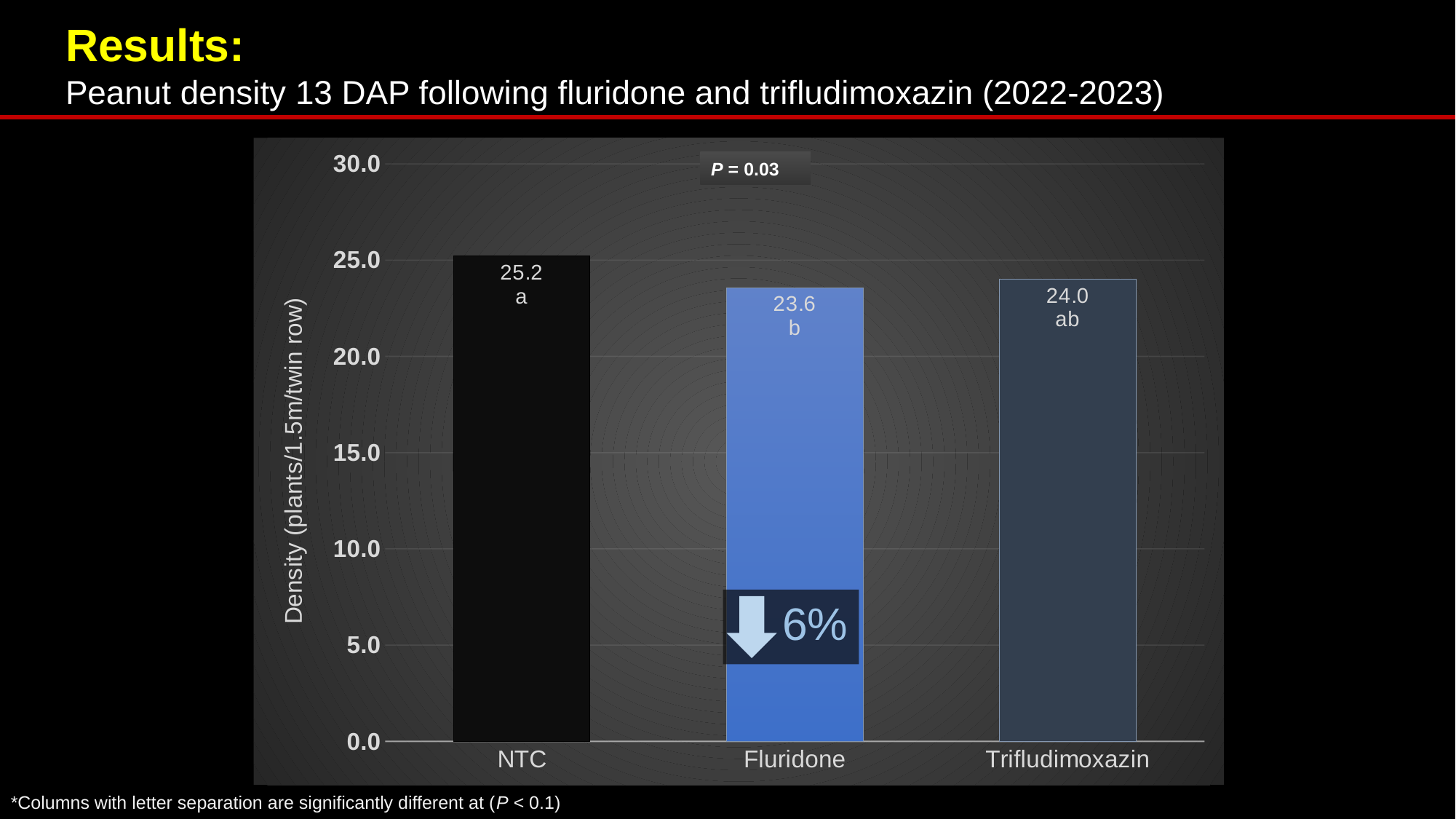
What is the peanut density value for Fluridone? 23.6 What is the peanut density value for NTC? 25.2 Which has a larger density value, Fluridone or Trifludimoxazin? Trifludimoxazin Which treatment has the lowest peanut density? Fluridone What kind of chart is shown on the slide? bar chart What is the difference in density between NTC and Fluridone? 1.6 How many treatments are shown on the x axis? 3 What P value is shown on the chart? P = 0.03 Is the value for Fluridone greater or less than 25.0? less What is the peanut density value for Trifludimoxazin? 24.0 What is the difference in density between NTC and Trifludimoxazin? 1.2 Which treatment has the highest peanut density? NTC